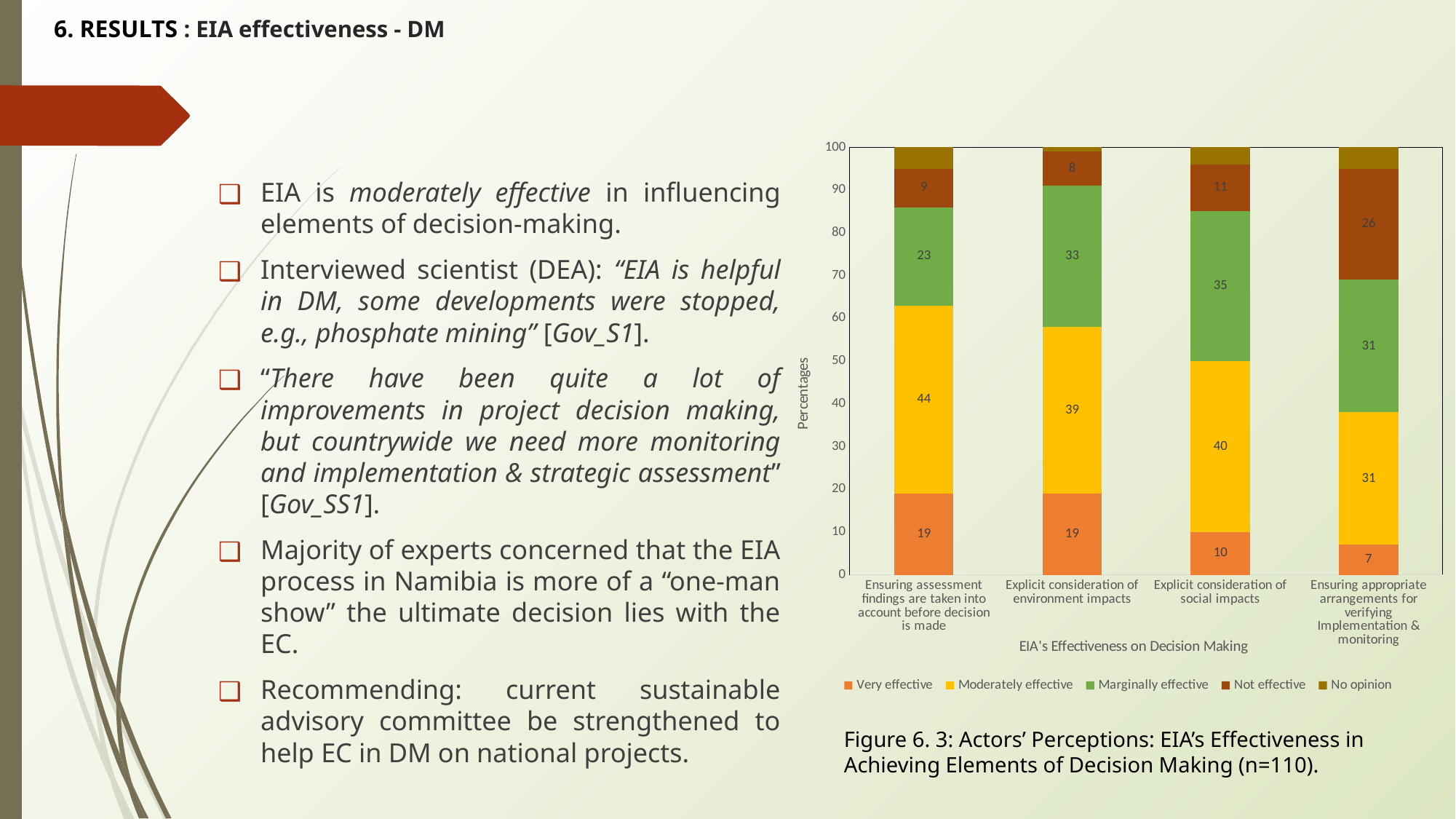
What is the 'Moderately effective' value for 'Ensuring assessment findings are taken into account before decision is made'? 44 What is the 'Not effective' value for 'Ensuring appropriate arrangements for verifying Implementation & monitoring'? 26 How many categories are shown on the x axis of the chart? 4 What is the label of the y axis of the chart? Percentages What type of chart is shown on the slide? stacked bar chart What is the difference between the 'Not effective' values for 'Ensuring appropriate arrangements for verifying Implementation & monitoring' and 'Explicit consideration of environment impacts'? 18 Which category has the lowest 'Very effective' value? Ensuring appropriate arrangements for verifying Implementation & monitoring Which category has the highest 'Moderately effective' value? Ensuring assessment findings are taken into account before decision is made Which colour represents the 'Moderately effective' series in the chart? yellow Which is larger: the 'Marginally effective' value for 'Explicit consideration of environment impacts' or for 'Ensuring assessment findings are taken into account before decision is made'? Explicit consideration of environment impacts How many series does the chart's legend list? 5 What is the 'Marginally effective' value for 'Explicit consideration of social impacts'? 35